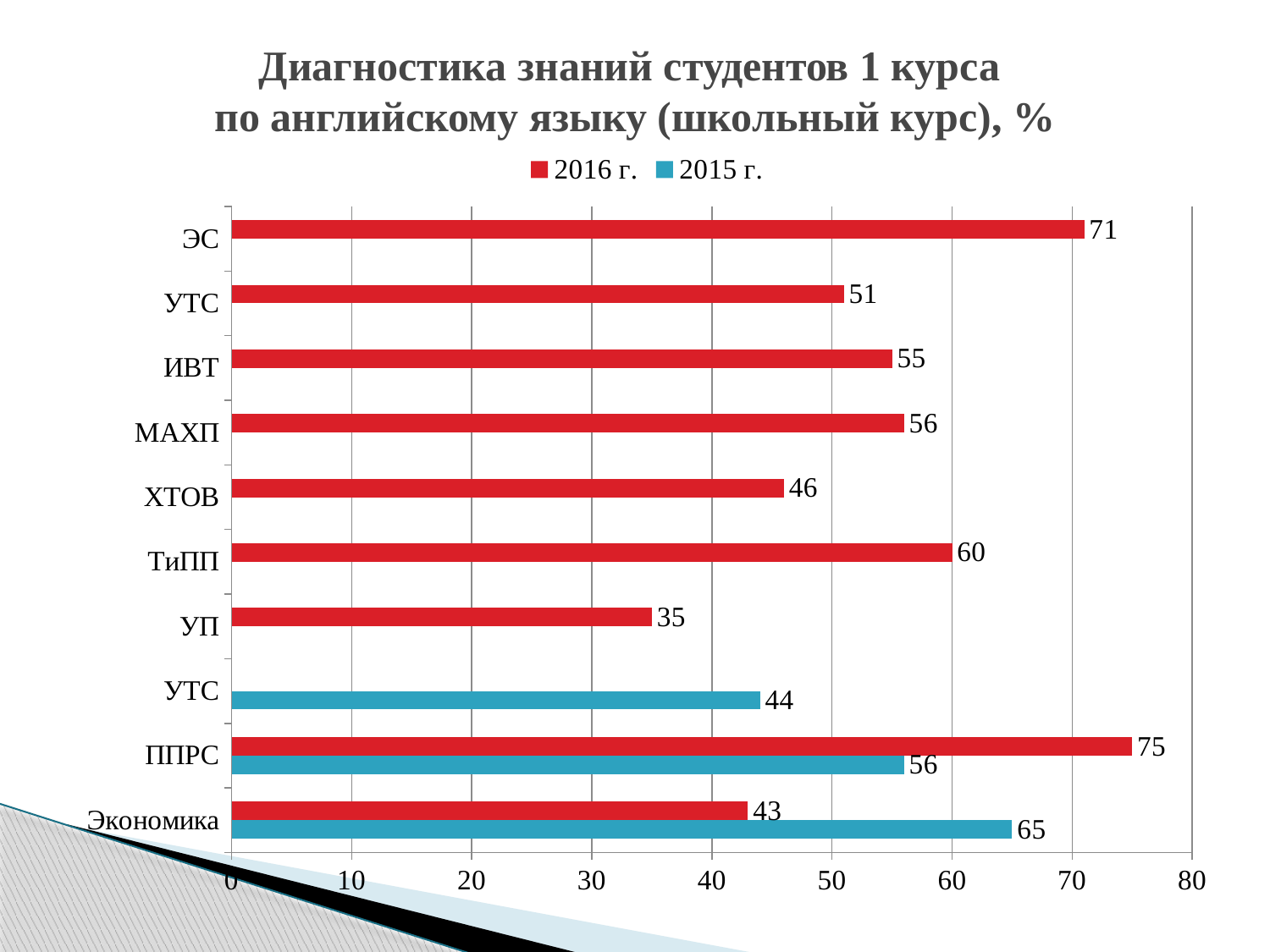
How many category labels are shown on the vertical axis? 10 What is the difference between the 2016 г. and 2015 г. values for ППРС? 19 Which category has the lowest 2016 г. value? УП What is the 2016 г. value for ТиПП? 60 Is the 2016 г. value for ХТОВ greater or less than 50? less What is the 2015 г. value for УТС? 44 What is the 2015 г. value for Экономика? 65 What type of chart is shown on the slide? bar chart Which is larger for Экономика, the 2016 г. value or the 2015 г. value? 2015 г. Which category has the highest 2016 г. value? ППРС How many series does the legend list? 2 What is the 2016 г. value for ЭС? 71